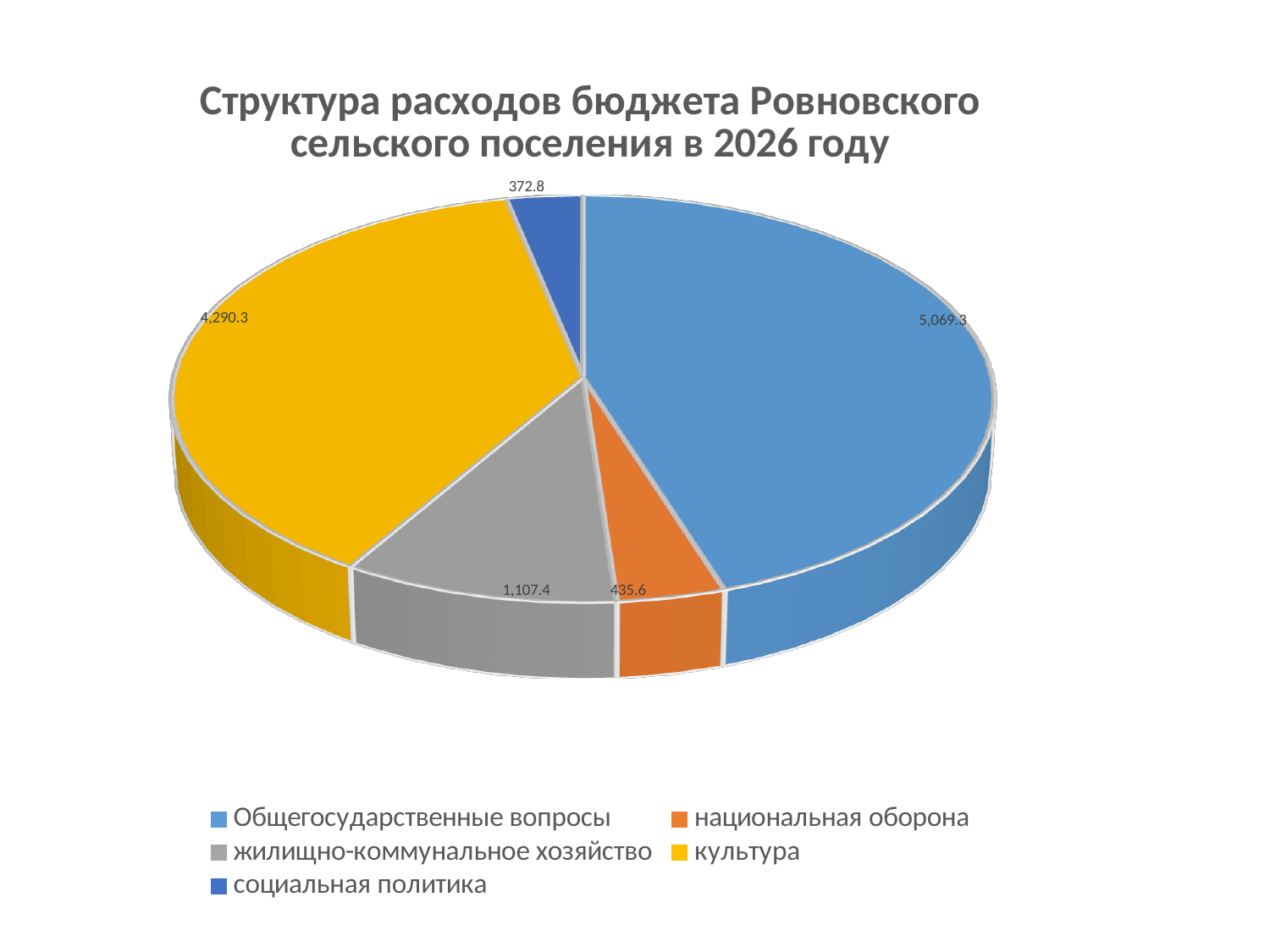
Which category has the smallest slice? социальная политика What is the value for Общегосударственные вопросы? 5,069.3 What is the difference between the values for Общегосударственные вопросы and культура? 779.0 What is the title of the chart? Структура расходов бюджета Ровновского сельского поселения в 2026 году Which is larger, национальная оборона or социальная политика? национальная оборона How many categories does the legend list? 5 What is the difference between the values for жилищно-коммунальное хозяйство and национальная оборона? 671.8 What is the value for культура? 4,290.3 What type of chart is shown on the slide? Pie chart Which category has the largest slice? Общегосударственные вопросы What is the value for жилищно-коммунальное хозяйство? 1,107.4 What is the value for социальная политика? 372.8